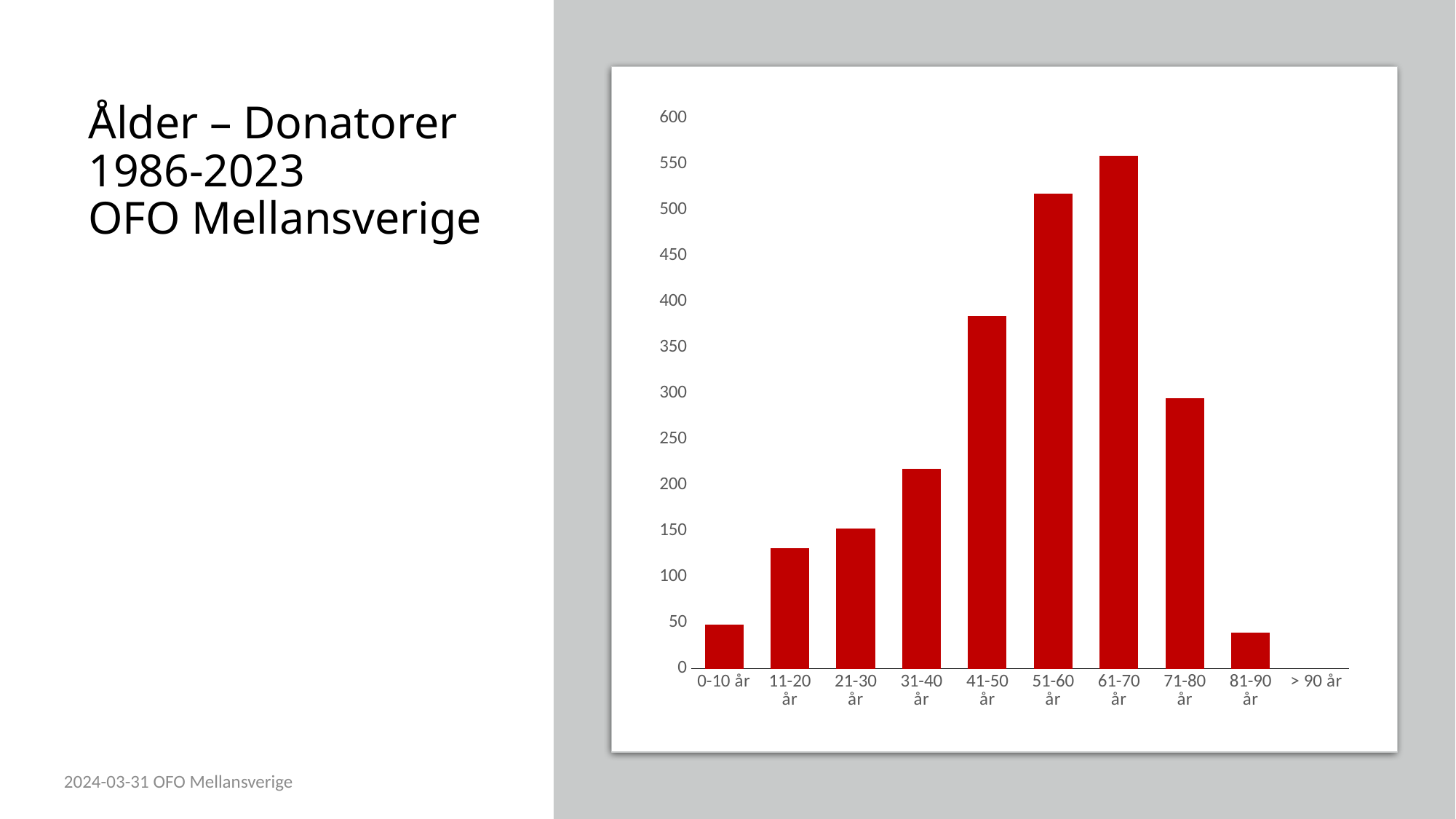
Is the value for 11-20 år greater or less than 100? greater Is the value for 61-70 år greater or less than 500? greater What colour are the bars in the chart? Red How many age groups are shown on the x axis of the chart? 10 Do the values rise or fall from 0-10 år to 61-70 år along the x axis? rise Is the value for 51-60 år greater or less than 450? greater Which age group has a larger value, 41-50 år or 71-80 år? 41-50 år Which age group has the highest bar in the chart? 61-70 år What kind of chart is shown on the slide? Bar chart